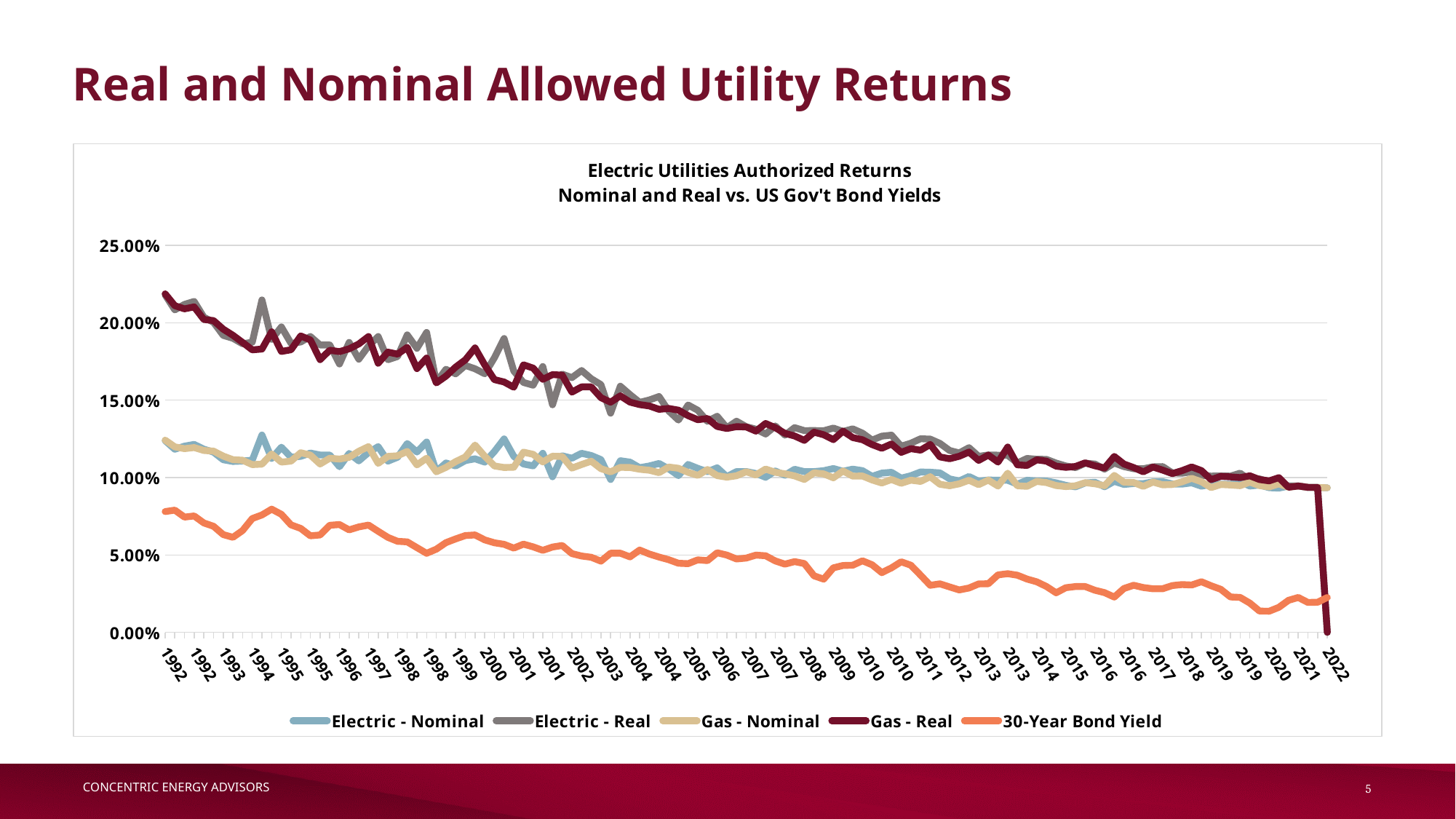
Is the value for 30-Year Bond Yield in 2020 greater or less than 5.00%? less Does the 30-Year Bond Yield generally rise or fall from 1992 to 2022? Fall How many series does the legend list? 5 Is the value for Gas - Real in 1992 greater or less than 20.00%? greater Which series is drawn in orange? 30-Year Bond Yield Is the value for 30-Year Bond Yield in 1992 greater or less than 5.00%? greater What kind of chart is shown on the slide? Line chart Does the Electric - Real series generally rise or fall across the x axis? Fall What is the title of the chart? Electric Utilities Authorized Returns Nominal and Real vs. US Gov't Bond Yields Which series has the lowest values throughout the chart? 30-Year Bond Yield In 1992, which is higher, Gas - Real or 30-Year Bond Yield? Gas - Real